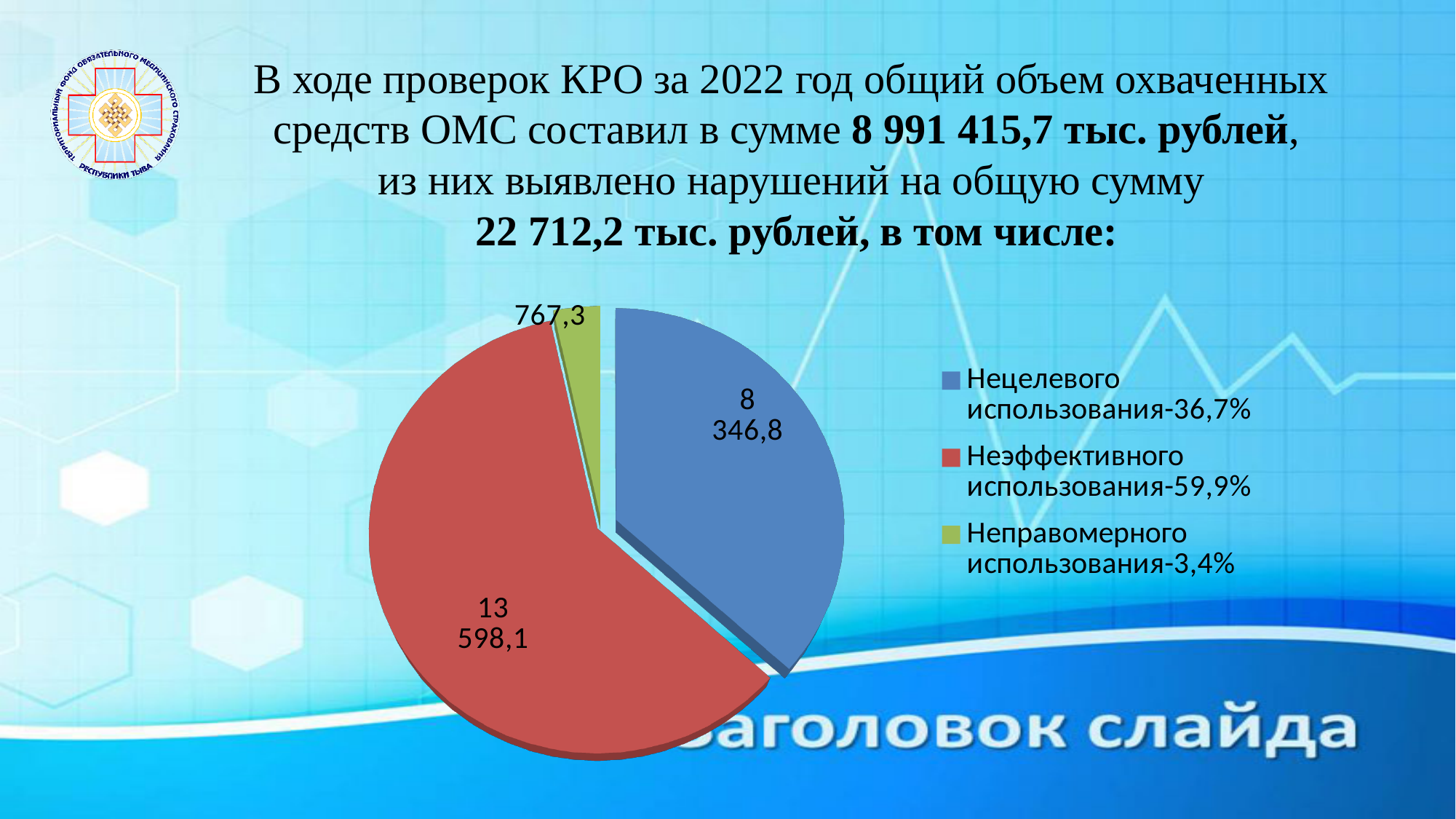
How many entries does the legend of the pie chart list? 3 How many slices does the pie chart have? 3 What kind of chart is shown on the slide? pie chart What colour is the slice for 'Неэффективного использования' in the pie chart? red Which is larger: the value for 'Нецелевого использования' or the value for 'Неправомерного использования'? Нецелевого использования What is the value shown for the slice 'Нецелевого использования'? 8 346,8 Which category has the smallest slice of the pie chart? Неправомерного использования Which category has the largest slice of the pie chart? Неэффективного использования What is the value shown for the slice 'Неправомерного использования'? 767,3 What share of the pie does 'Неэффективного использования' represent, according to the legend? 59,9% What is the value shown for the slice 'Неэффективного использования'? 13 598,1 What share of the pie does 'Неправомерного использования' represent, according to the legend? 3,4%